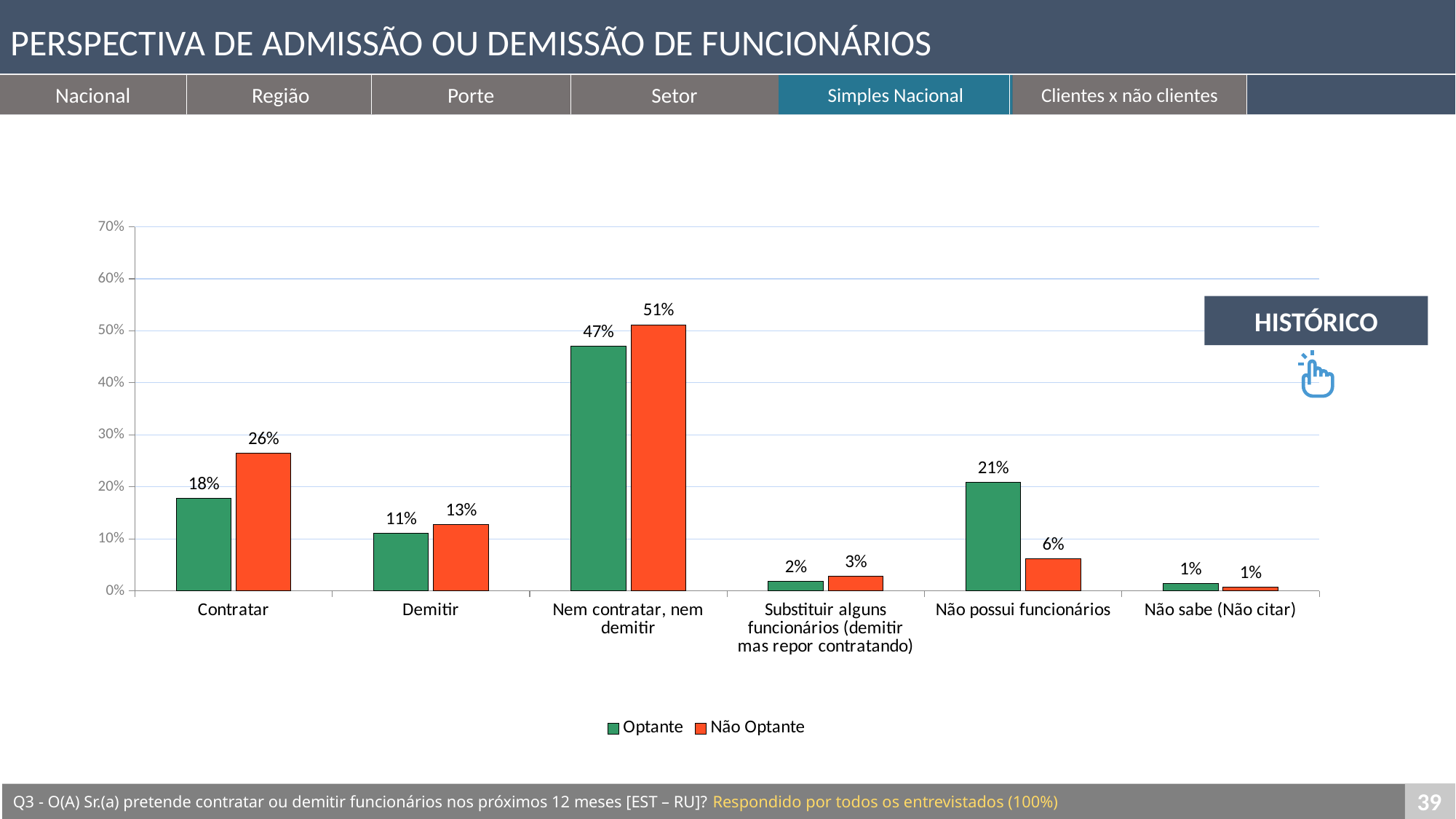
What is the value for Optante in the Contratar category? 18% What is the value for Não Optante in the Nem contratar, nem demitir category? 51% Which category has the lowest value for the Não Optante series? Não sabe (Não citar) Which category has the highest value for the Optante series? Nem contratar, nem demitir What is the difference between Optante and Não Optante in the Não possui funcionários category? 15% What is the difference between Não Optante and Optante in the Contratar category? 8% In the Demitir category, which series has the larger value, Optante or Não Optante? Não Optante What is the value for Não Optante in the Não possui funcionários category? 6% How many categories are shown on the x axis? 6 How many series does the legend list? 2 What kind of chart is shown on the slide? Bar chart Which colour represents the Não Optante series? Orange-red